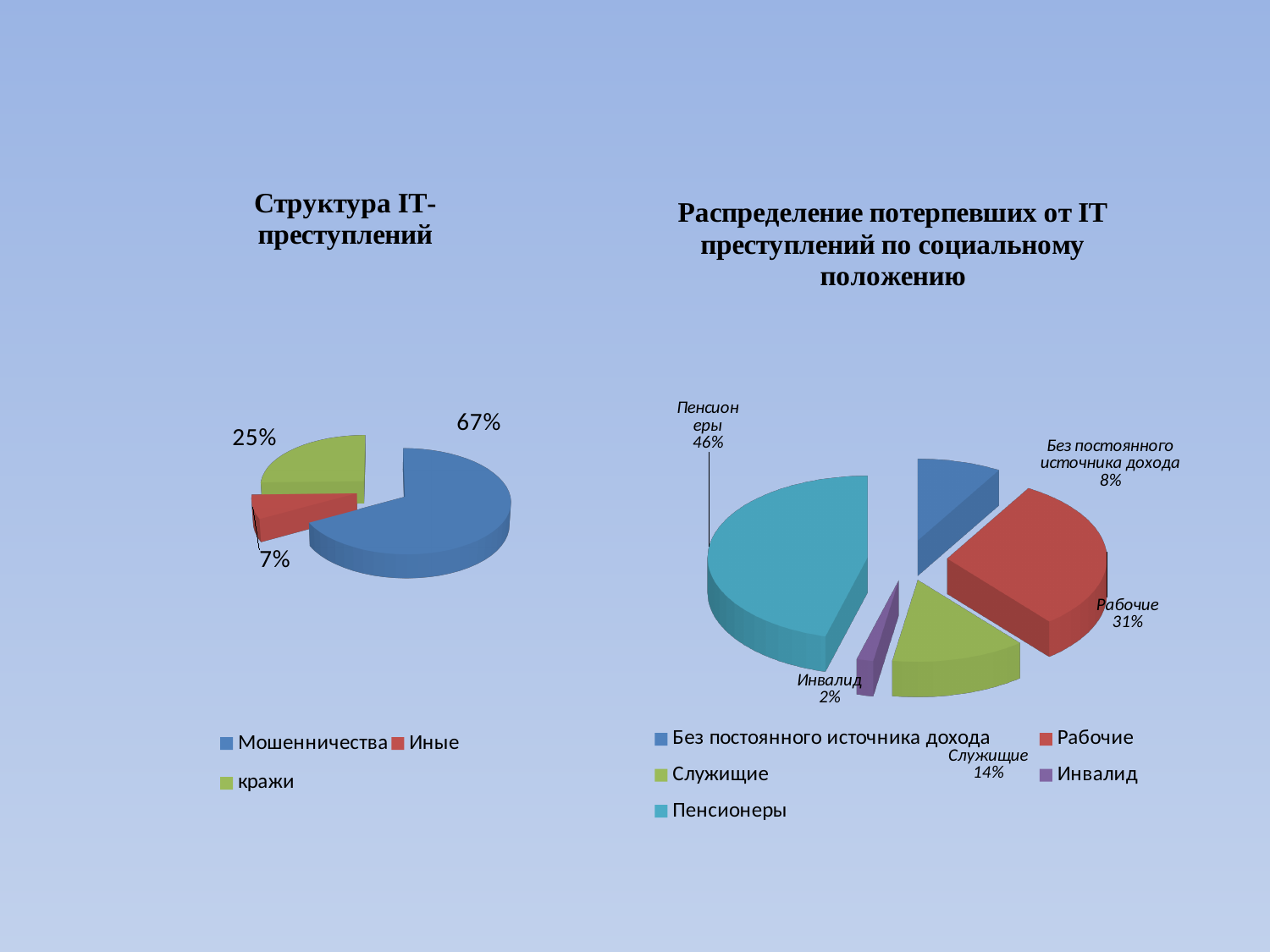
In the chart titled "Распределение потерпевших от IT преступлений по социальному положению", what is the difference in percentage points between Пенсионеры and Рабочие? 15 In the chart titled "Структура IT-преступлений", what share is labelled for Мошенничества? 67% In the chart titled "Распределение потерпевших от IT преступлений по социальному положению", what share is labelled for Пенсионеры? 46% In the chart titled "Распределение потерпевших от IT преступлений по социальному положению", how many categories does the legend list? 5 In the chart titled "Структура IT-преступлений", what share is labelled for кражи? 25% In the chart titled "Структура IT-преступлений", what is the difference in percentage points between Мошенничества and кражи? 42 In the chart titled "Структура IT-преступлений", which category has the smallest slice? Иные In the chart titled "Структура IT-преступлений", how many categories does the legend list? 3 In the chart titled "Распределение потерпевших от IT преступлений по социальному положению", what share is labelled for Рабочие? 31% In the chart titled "Распределение потерпевших от IT преступлений по социальному положению", which category has the smallest share? Инвалид What type of chart is the one titled "Структура IT-преступлений"? Pie chart In the chart titled "Распределение потерпевших от IT преступлений по социальному положению", which is larger: Служащие or Без постоянного источника дохода? Служищие